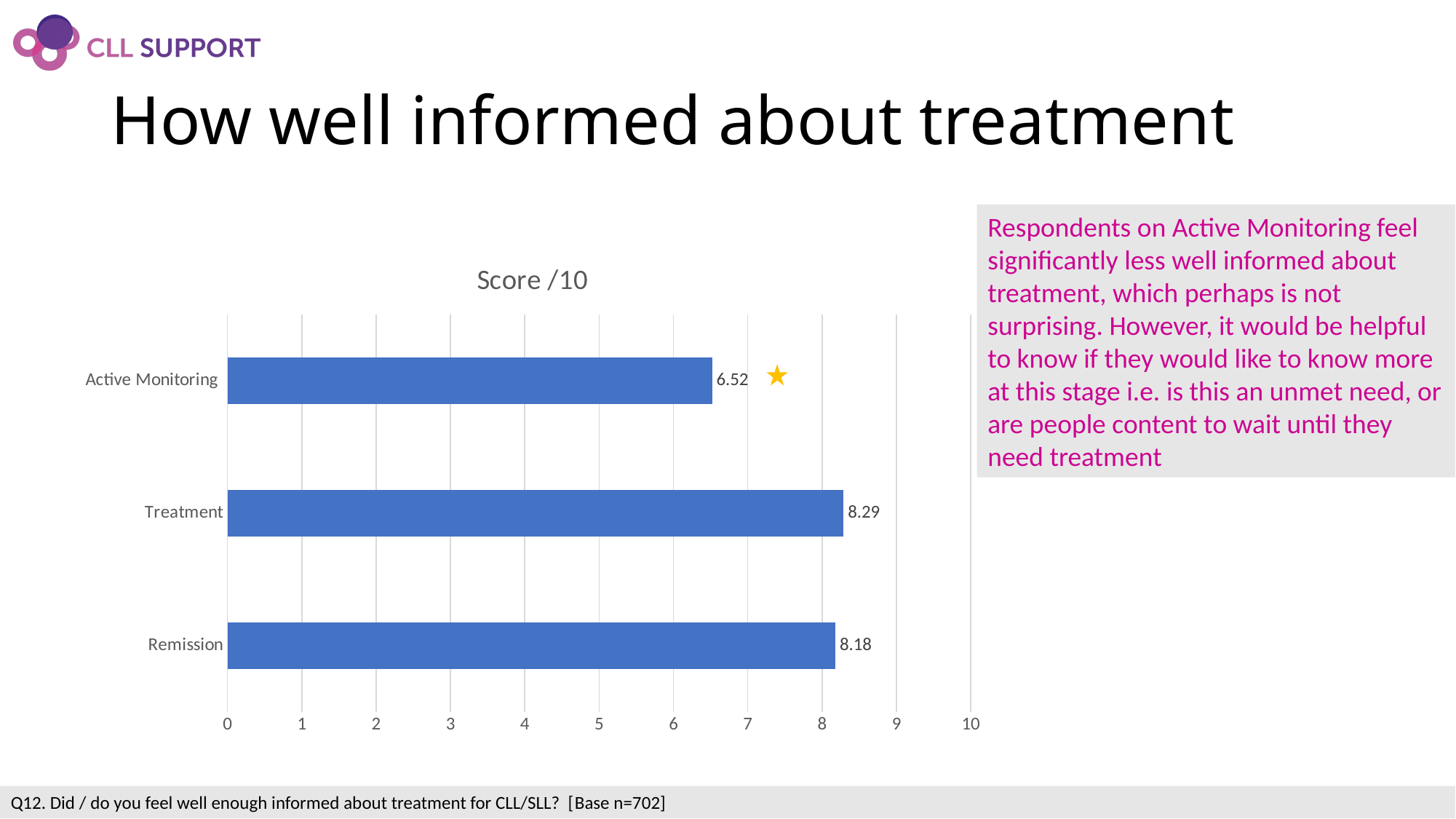
What is the score for Treatment? 8.29 What is the score for Remission? 8.18 What kind of chart is shown on the slide? Bar chart Is the value for Active Monitoring greater or less than 7? less What is the difference between the Treatment score and the Remission score? 0.11 What is the score for Active Monitoring? 6.52 Which category has the highest score? Treatment Which has a higher score, Active Monitoring or Remission? Remission Which category has the lowest score? Active Monitoring How many categories are shown in the chart? 3 What is the difference between the Treatment score and the Active Monitoring score? 1.77 What is the title of the chart? Score /10